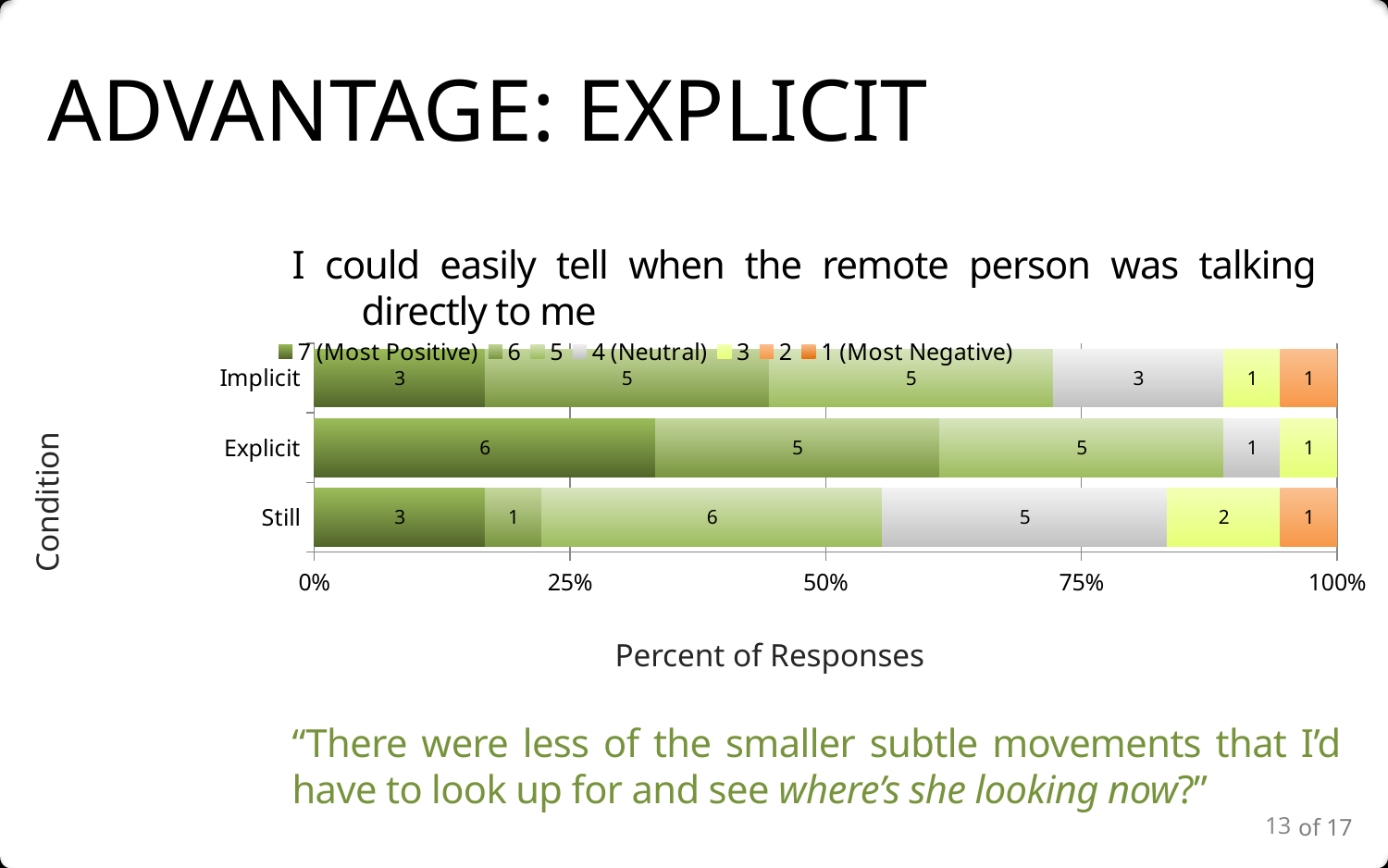
How many responses of 7 (Most Positive) did the Explicit condition receive? 6 What is the total number of responses shown in the Explicit bar? 18 How many series does the chart's legend list? 7 How many responses of 4 (Neutral) did the Implicit condition receive? 3 What kind of chart is shown on the slide? Stacked bar chart Which condition received the most responses of 7 (Most Positive)? Explicit What is the title of the chart's x axis? Percent of Responses How many responses of 5 did the Still condition receive? 6 What is the difference between the number of 7 (Most Positive) responses for Explicit and for Implicit? 3 How many conditions are plotted on the y axis of the chart? 3 Which condition has more 4 (Neutral) responses, Still or Explicit? Still How many responses of 6 did the Still condition receive? 1